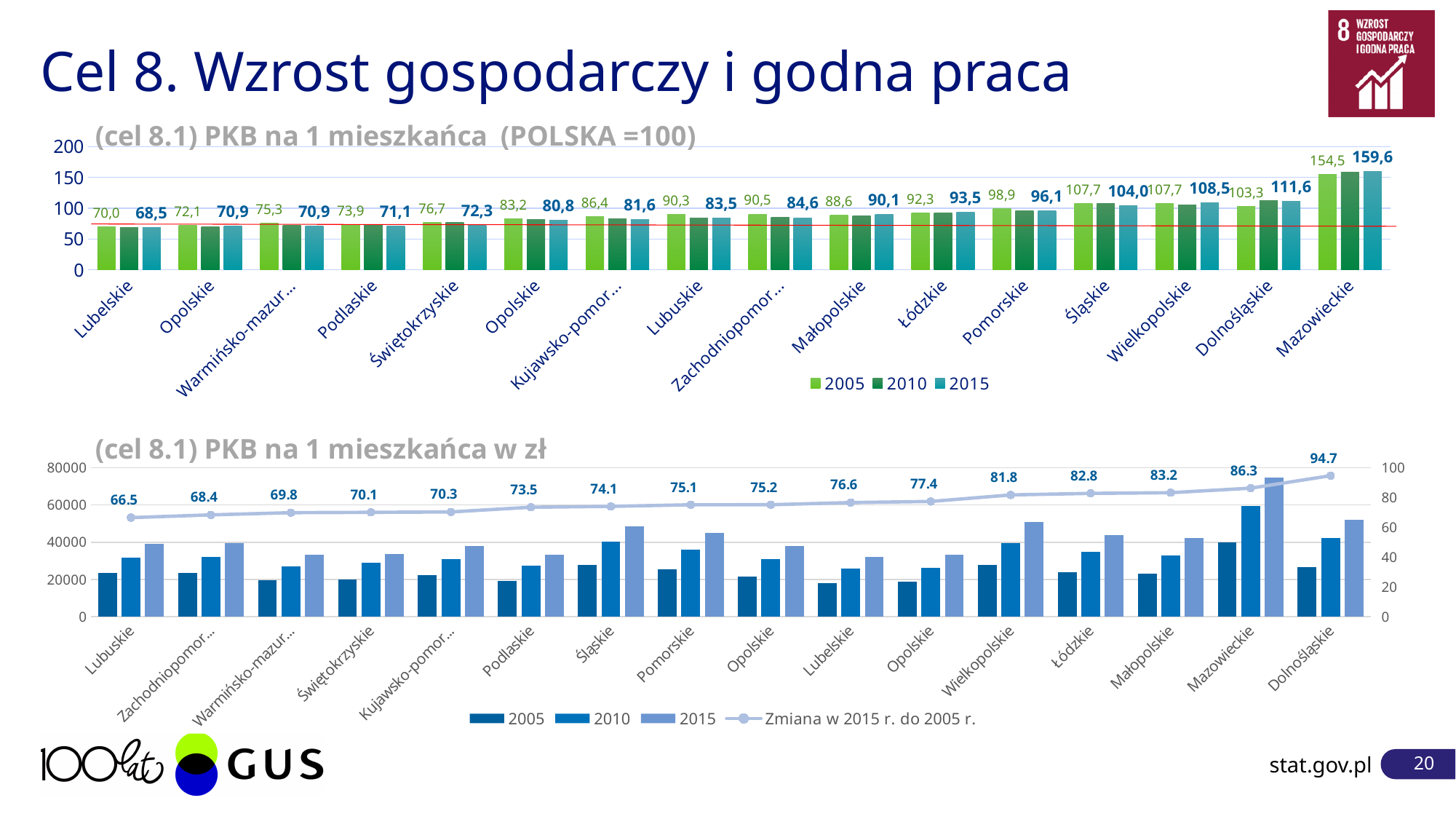
In the top chart '(cel 8.1) PKB na 1 mieszkańca (POLSKA =100)', what is the 2015 value for Mazowieckie? 159,6 In the bottom chart '(cel 8.1) PKB na 1 mieszkańca w zł', is the 2015 value for Mazowieckie greater or less than 60000? greater In the bottom chart '(cel 8.1) PKB na 1 mieszkańca w zł', what is the value of 'Zmiana w 2015 r. do 2005 r.' for Dolnośląskie? 94.7 In the top chart '(cel 8.1) PKB na 1 mieszkańca (POLSKA =100)', which region has the lowest 2015 value? Lubelskie In the bottom chart '(cel 8.1) PKB na 1 mieszkańca w zł', what is the value of 'Zmiana w 2015 r. do 2005 r.' for Lubuskie? 66.5 In the top chart '(cel 8.1) PKB na 1 mieszkańca (POLSKA =100)', which region has the highest 2015 value? Mazowieckie In the top chart '(cel 8.1) PKB na 1 mieszkańca (POLSKA =100)', what is the 2005 value for Lubelskie? 70,0 How many series does the legend of the top chart '(cel 8.1) PKB na 1 mieszkańca (POLSKA =100)' list? 3 In the top chart '(cel 8.1) PKB na 1 mieszkańca (POLSKA =100)', which is larger in 2015: Śląskie or Wielkopolskie? Wielkopolskie In the top chart '(cel 8.1) PKB na 1 mieszkańca (POLSKA =100)', by how much did the value for Mazowieckie increase from 2005 to 2015? 5,1 In the bottom chart '(cel 8.1) PKB na 1 mieszkańca w zł', does the line 'Zmiana w 2015 r. do 2005 r.' rise or fall from left to right? rise How many regions are shown on the x axis of the top chart '(cel 8.1) PKB na 1 mieszkańca (POLSKA =100)'? 16